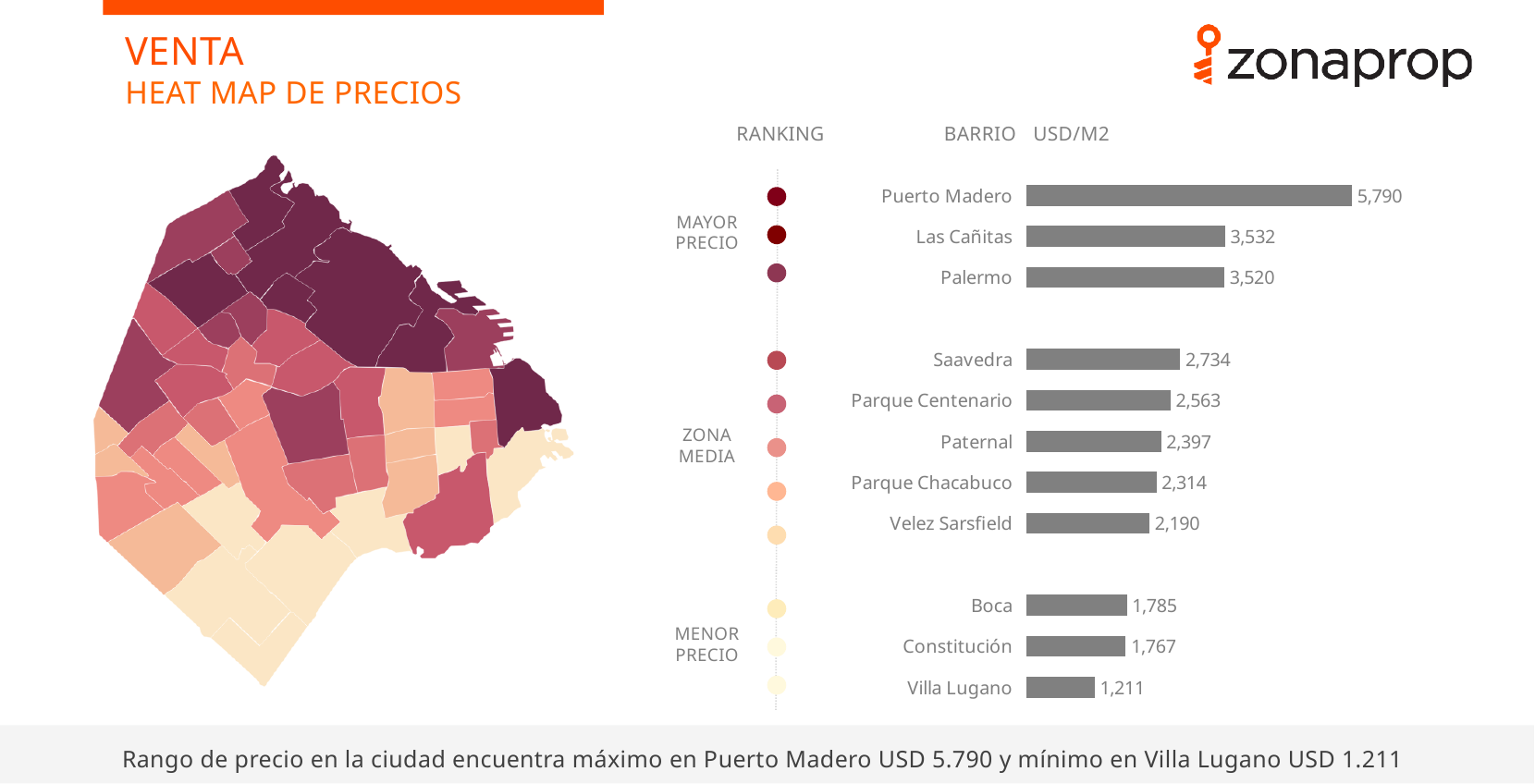
What kind of chart shows the USD/M2 values by barrio? Bar chart What is the USD/M2 value for Puerto Madero? 5,790 Which barrio has the lowest USD/M2 value? Villa Lugano Do the USD/M2 values increase or decrease from the top bar to the bottom bar? Decrease Which barrio has the highest USD/M2 value? Puerto Madero How many barrios are shown in the bar chart? 11 What is the USD/M2 value for Parque Chacabuco? 2,314 What is the difference in USD/M2 between Puerto Madero and Villa Lugano? 4,579 What is the USD/M2 value for Saavedra? 2,734 What is the difference in USD/M2 between Saavedra and Parque Centenario? 171 Which has a higher USD/M2 value, Boca or Velez Sarsfield? Velez Sarsfield What is the USD/M2 value for Villa Lugano? 1,211